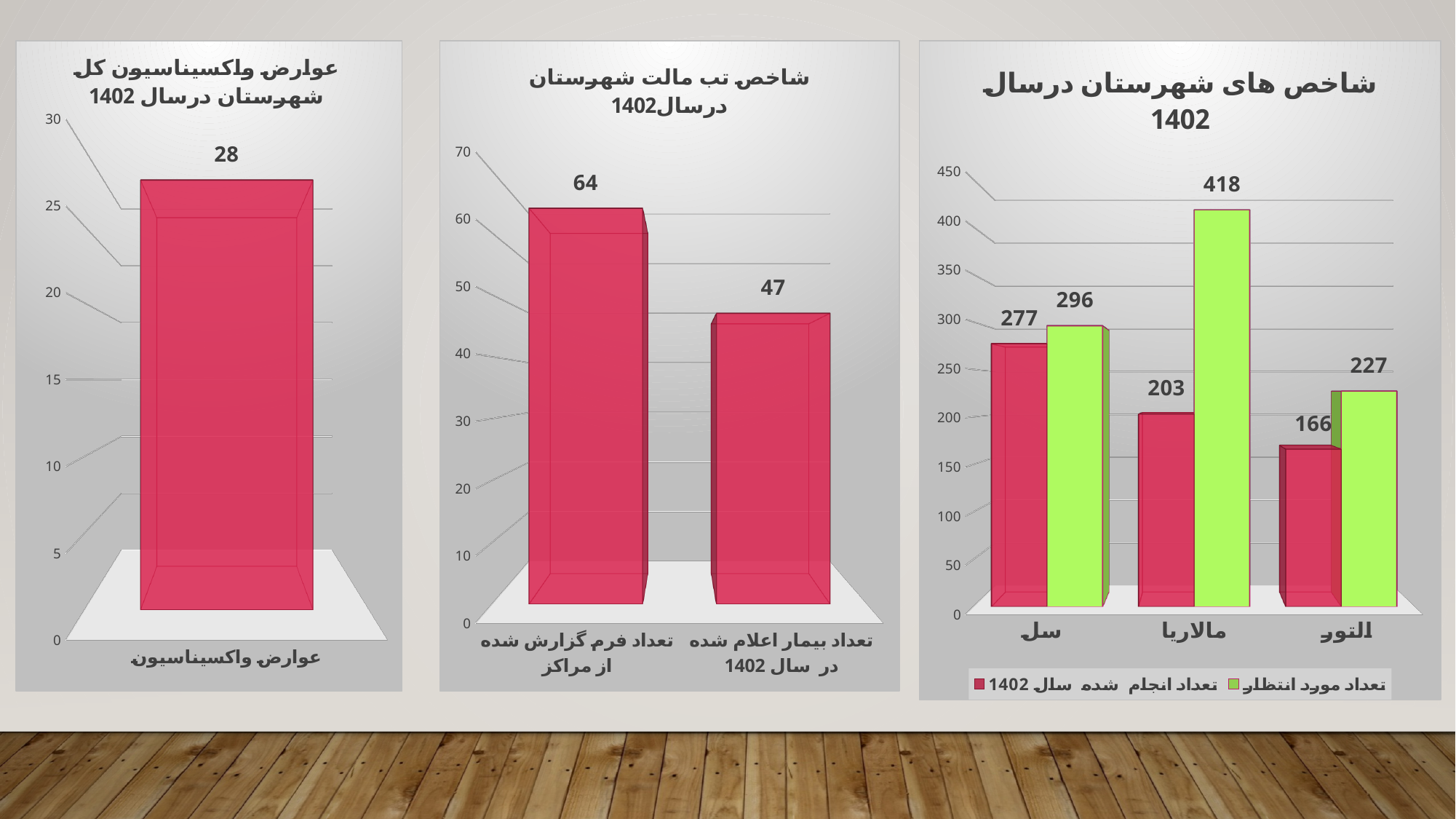
In the right chart, what is the value of تعداد انجام شده سال 1402 for التور? 166 In the middle chart, what is the difference between تعداد فرم گزارش شده از مراکز and تعداد بیمار اعلام شده در سال 1402? 17 In the left chart (عوارض واکسیناسیون کل شهرستان درسال 1402), what is the value of the bar for عوارض واکسیناسیون? 28 In the right chart (شاخص های شهرستان درسال 1402), what is the value of تعداد مورد انتظار for مالاریا? 418 In the left chart, is the value for عوارض واکسیناسیون greater or less than 25? greater In the right chart, which category has the lowest value for تعداد انجام شده سال 1402? التور In the right chart, which category has the highest value for تعداد مورد انتظار? مالاریا In the middle chart (شاخص تب مالت شهرستان درسال1402), what is the value for تعداد فرم گزارش شده از مراکز? 64 In the right chart, how many series does the legend list? 2 In the right chart, what is the difference between تعداد مورد انتظار and تعداد انجام شده سال 1402 for سل? 19 In the middle chart, what is the value for تعداد بیمار اعلام شده در سال 1402? 47 In the middle chart, how many bars are plotted? 2